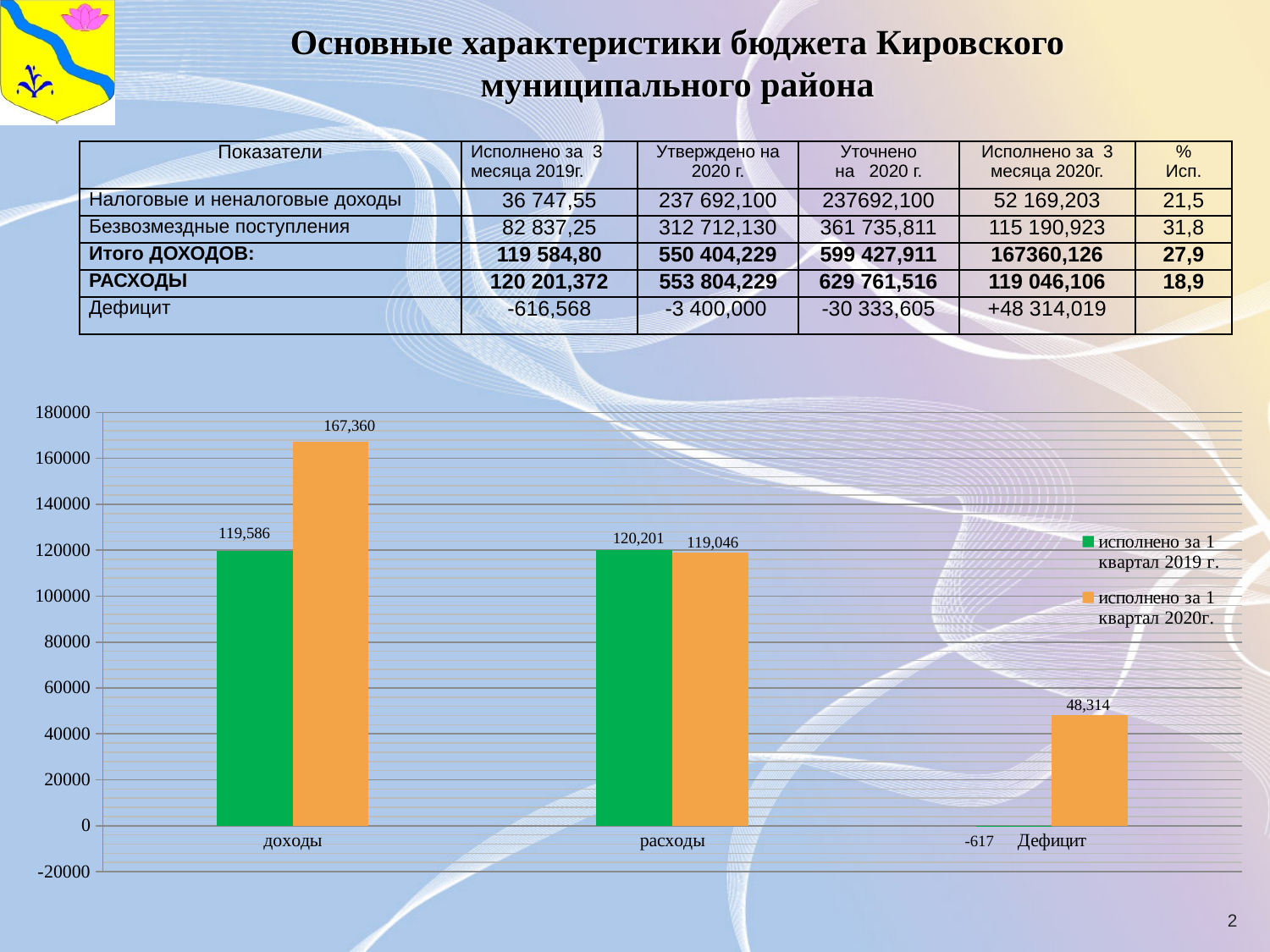
What is the difference between the 2020 and 2019 values for доходы? 47,774 What is the value for доходы in the series исполнено за 1 квартал 2020г.? 167,360 How many series does the chart legend list? 2 Which category has the highest value in the series исполнено за 1 квартал 2020г.? доходы How many categories are shown on the x axis of the chart? 3 What type of chart is shown on the slide? bar chart Which series is shown in green in the chart? исполнено за 1 квартал 2019 г. What is the value for Дефицит in the series исполнено за 1 квартал 2019 г.? -617 What is the value for расходы in the series исполнено за 1 квартал 2019 г.? 120,201 Which category has the lowest value in the series исполнено за 1 квартал 2019 г.? Дефицит What is the value for доходы in the series исполнено за 1 квартал 2019 г.? 119,586 What is the value for Дефицит in the series исполнено за 1 квартал 2020г.? 48,314